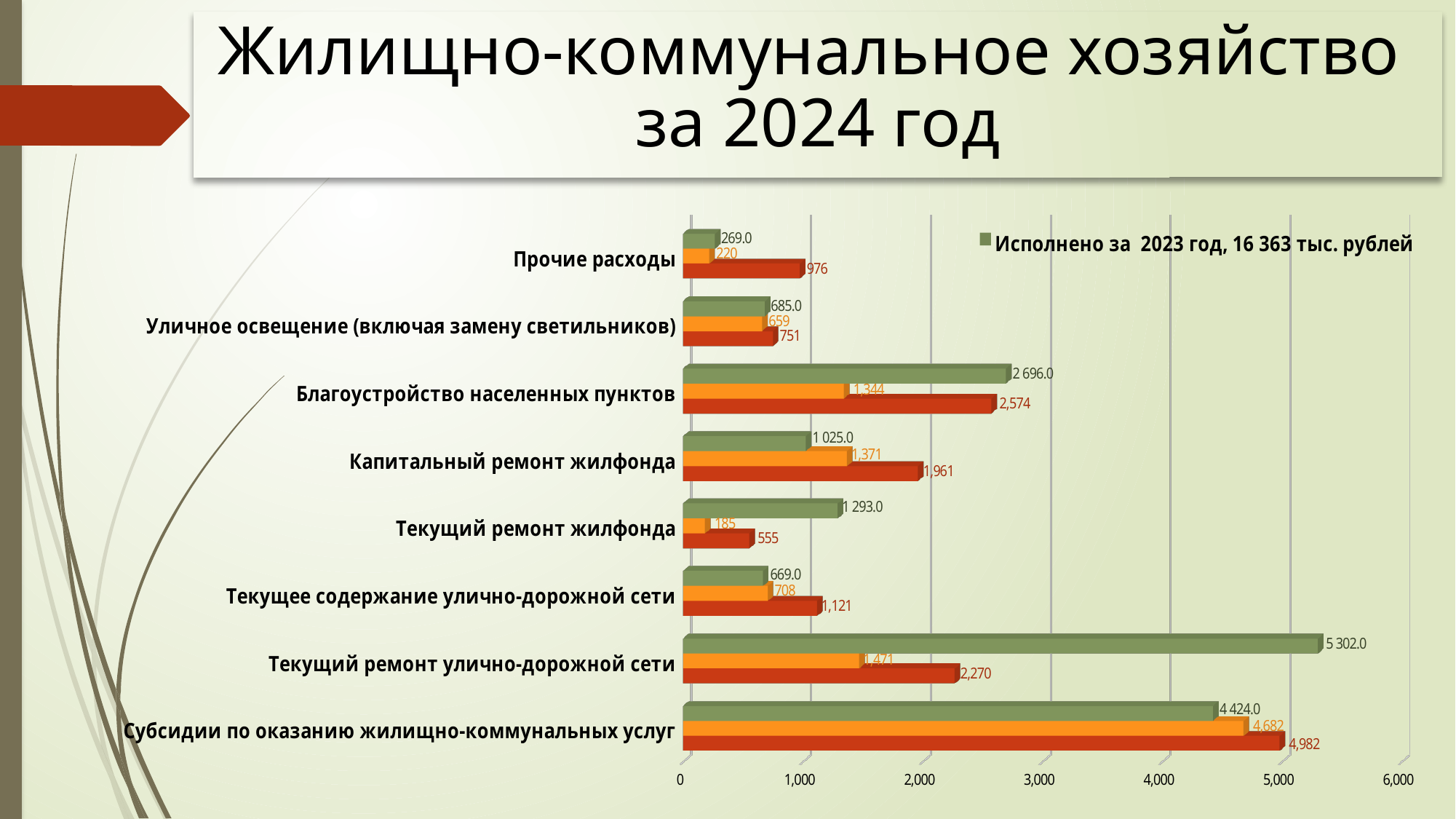
What kind of chart is shown on the slide? bar chart For 'Субсидии по оказанию жилищно-коммунальных услуг', what is the difference between the red bar (4,982) and the 'Исполнено за 2023 год' value (4 424.0)? 558 Which category has the highest value for 'Исполнено за 2023 год'? Текущий ремонт улично-дорожной сети Is the 'Исполнено за 2023 год' value for 'Субсидии по оказанию жилищно-коммунальных услуг' greater or less than 4,000? greater What is the value of the red bar for 'Субсидии по оказанию жилищно-коммунальных услуг'? 4,982 How many categories are shown on the chart? 8 What is the value of 'Исполнено за 2023 год' for 'Благоустройство населенных пунктов'? 2 696.0 What is the value of 'Исполнено за 2023 год' for 'Текущий ремонт улично-дорожной сети'? 5 302.0 For 'Прочие расходы', what is the difference between the red bar (976) and the orange bar (220)? 756 Which category has the lowest value for 'Исполнено за 2023 год'? Прочие расходы For 'Капитальный ремонт жилфонда', which is larger: the 'Исполнено за 2023 год' value or the red bar value? the red bar value What is the legend entry shown on the chart? Исполнено за 2023 год, 16 363 тыс. рублей